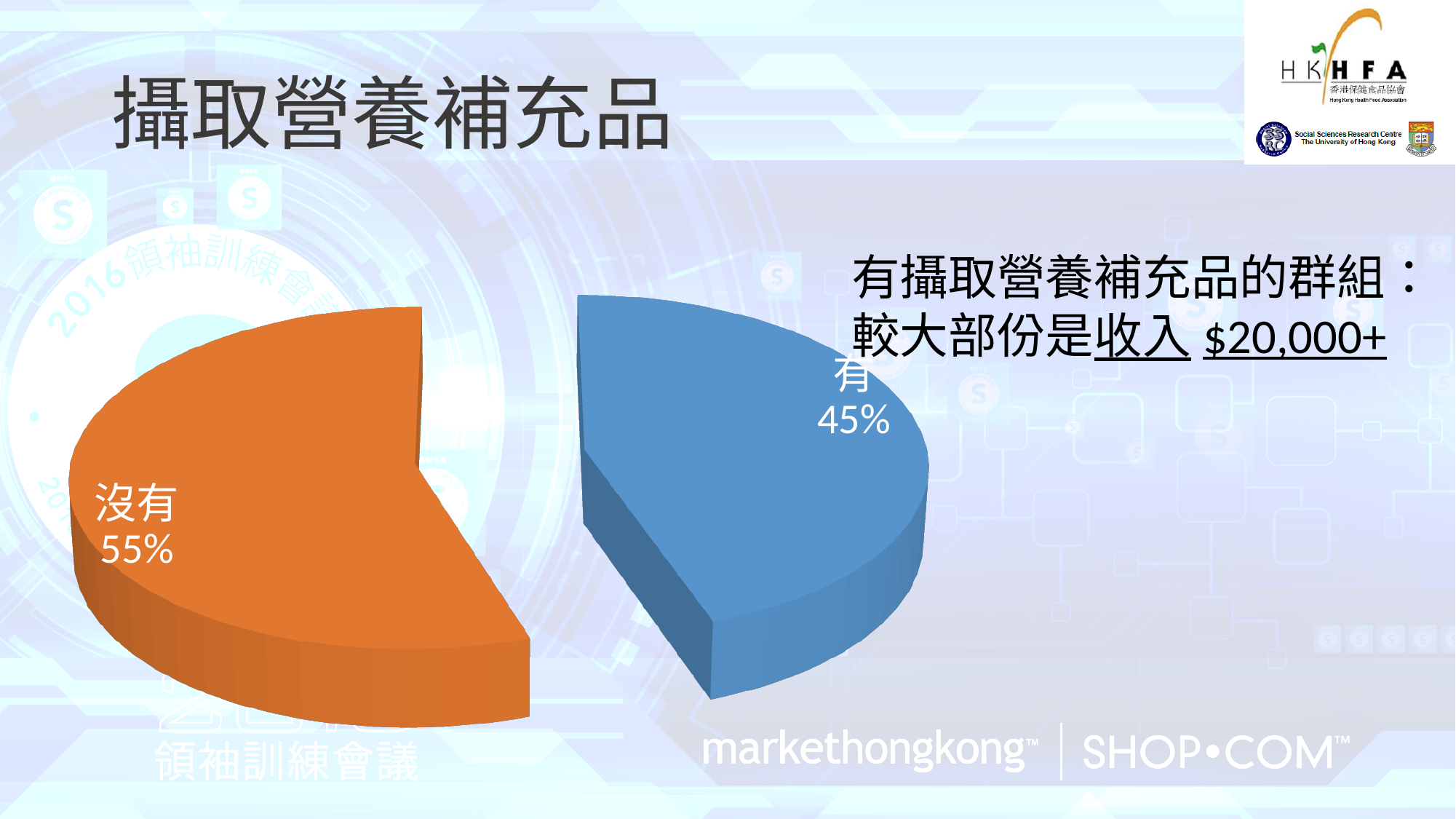
Which is larger, the 有 slice or the 沒有 slice? 沒有 What colour is the 沒有 slice? orange Which slice of the pie is the largest? 沒有 What percentage of the pie is labelled 有? 45% How many slices does the pie chart have? 2 What kind of chart is shown on the slide? pie chart What share of the pie does the 有 slice represent? 45% Which slice of the pie is the smallest? 有 What colour is the 有 slice? blue What percentage of the pie is labelled 沒有? 55% What is the difference in percentage points between the 沒有 slice and the 有 slice? 10